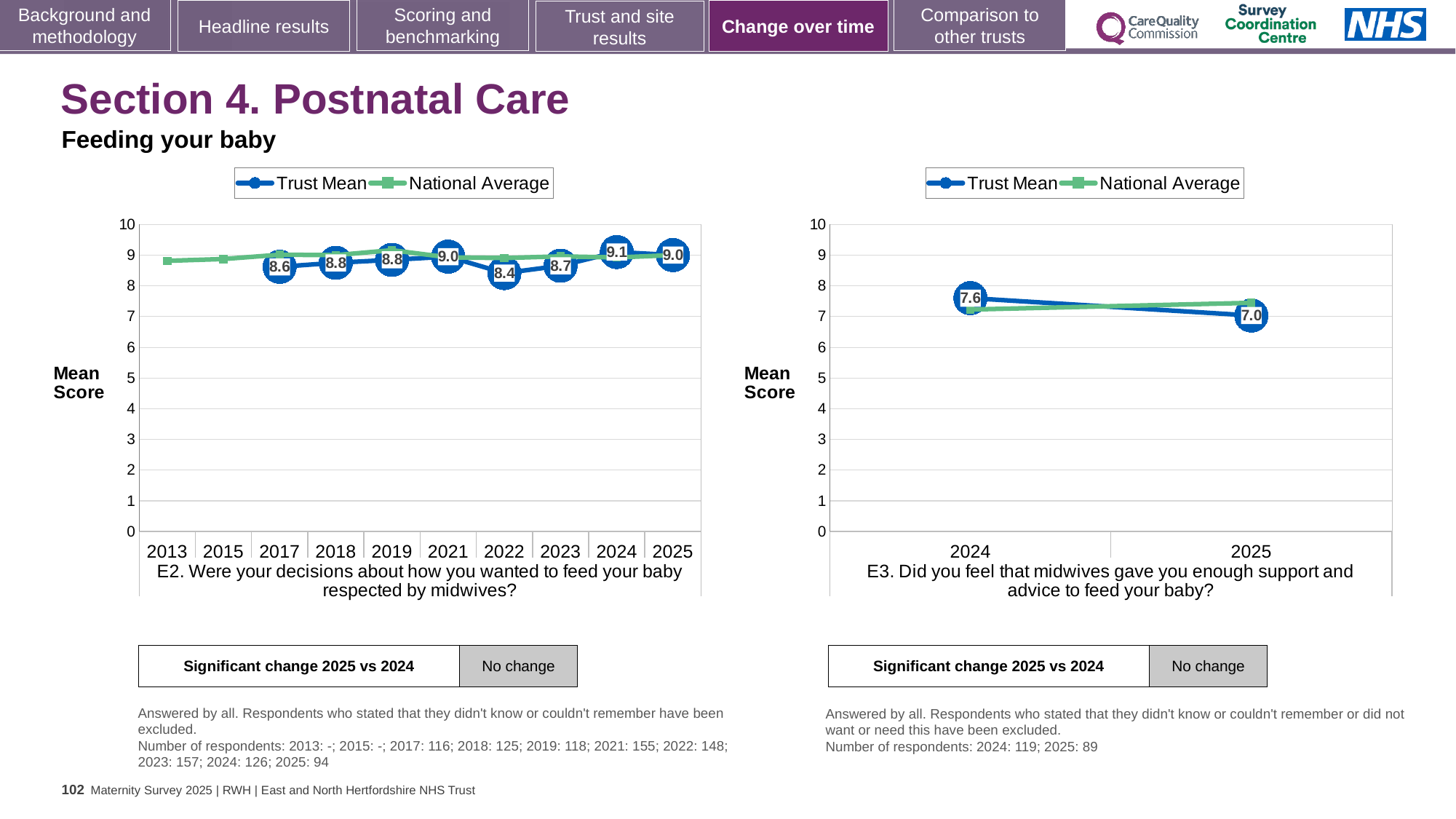
In the E3 chart on the right, did the Trust Mean rise or fall from 2024 to 2025? fall In the E2 chart on the left, which year has the highest Trust Mean? 2024 In the E3 chart on the right, what is the Trust Mean for 2024? 7.6 How many series does the legend of the E3 chart on the right list? 2 In the E2 chart on the left, what is the Trust Mean for 2025? 9.0 In the E2 chart on the left, what is the difference between the Trust Mean for 2024 and 2022? 0.7 In the E2 chart on the left, which year has the lowest labelled Trust Mean? 2022 In the E2 chart on the left, what is the Trust Mean for 2022? 8.4 What kind of chart is the E2 chart on the left? line chart In the E2 chart on the left, how many years are shown on the x axis? 10 In the E3 chart on the right, what is the Trust Mean for 2025? 7.0 In the E3 chart on the right, is the Trust Mean for 2025 greater or less than 8? less